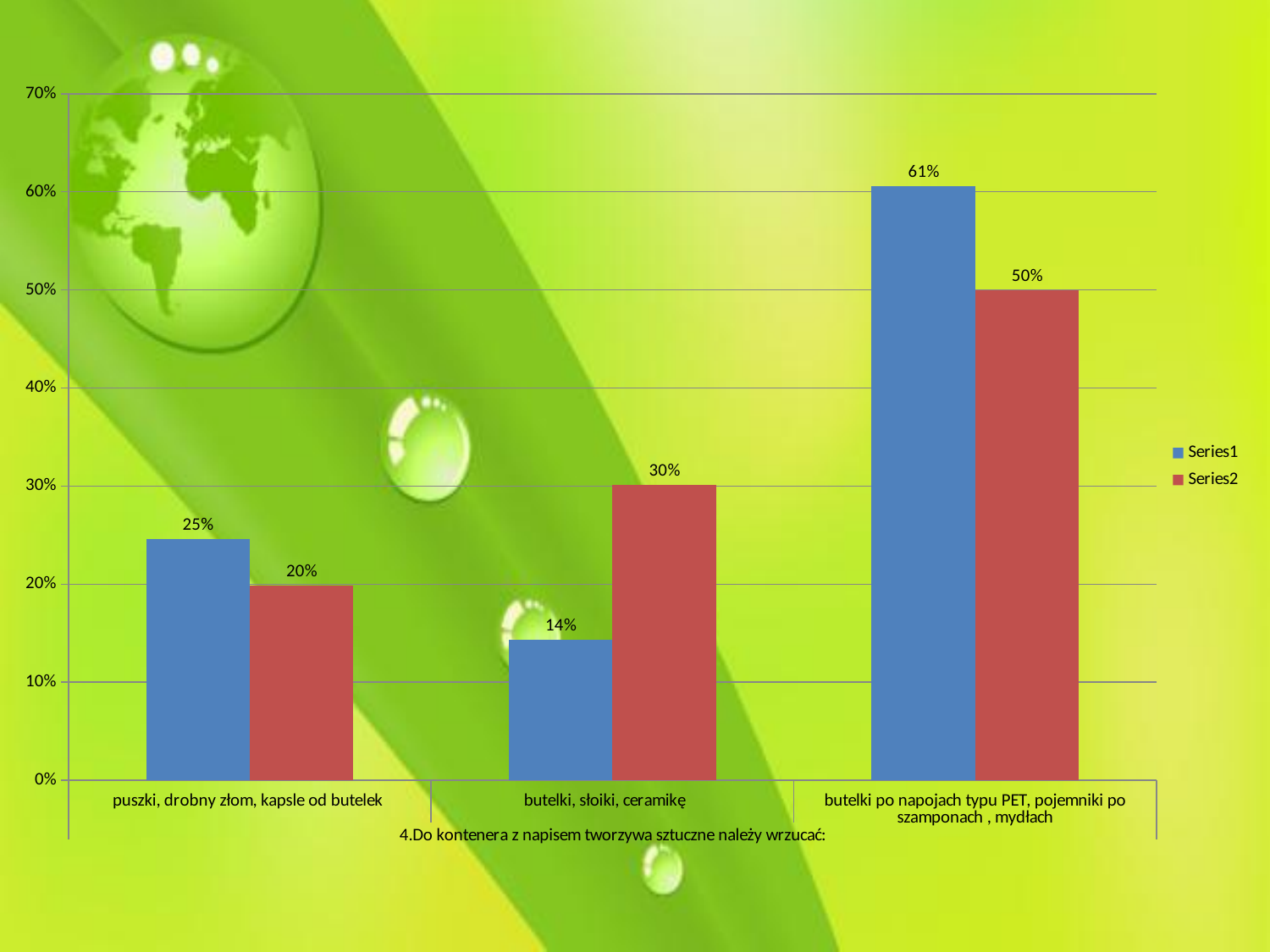
What is the Series1 value for "puszki, drobny złom, kapsle od butelek"? 25% Which category has the highest Series2 value? butelki po napojach typu PET, pojemniki po szamponach , mydłach How many series does the legend list? 2 What is the difference between the Series1 and Series2 values for "butelki po napojach typu PET, pojemniki po szamponach , mydłach"? 11% Is the Series2 value for "puszki, drobny złom, kapsle od butelek" greater or less than 30%? less Which category has the lowest Series1 value? butelki, słoiki, ceramikę What kind of chart is shown on the slide? bar chart What is the Series1 value for "butelki po napojach typu PET, pojemniki po szamponach , mydłach"? 61% How many categories are shown on the x axis? 3 What is the x-axis title of the chart? 4.Do kontenera z napisem tworzywa sztuczne należy wrzucać: What is the Series2 value for "butelki, słoiki, ceramikę"? 30% For "butelki, słoiki, ceramikę", which series has the larger value, Series1 or Series2? Series2